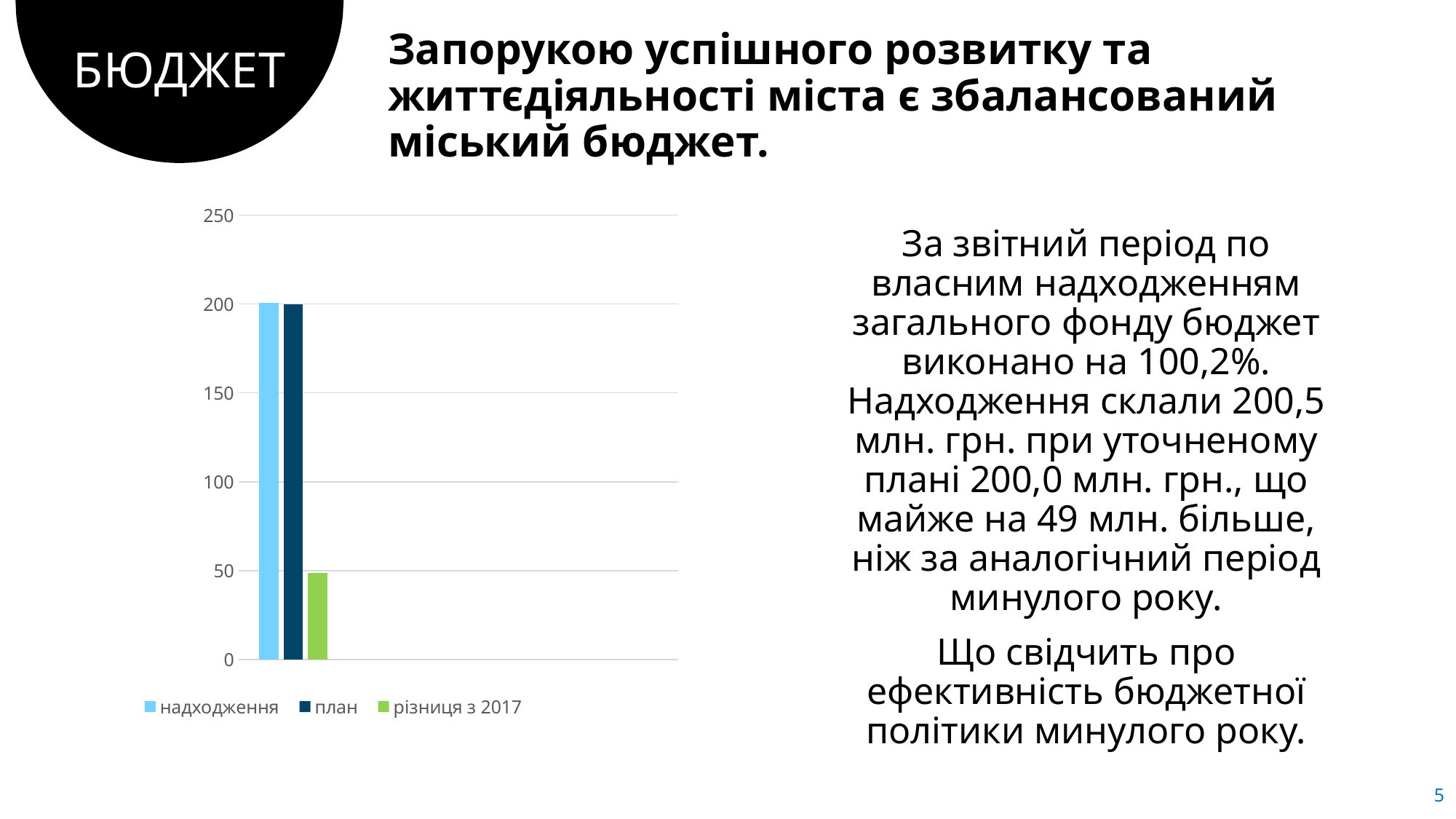
What colour is the bar for the series різниця з 2017? green How many series does the chart legend list? 3 Is the value for надходження greater or less than 150? greater Which is larger in the chart, the value for план or the value for різниця з 2017? план Is the value for план greater or less than 150? greater What is the highest value shown on the chart's vertical axis? 250 What kind of chart is shown on the slide? bar chart Is the value for надходження greater or less than 250? less Which is larger in the chart, the value for надходження or the value for різниця з 2017? надходження Which series has the lowest value in the chart? різниця з 2017